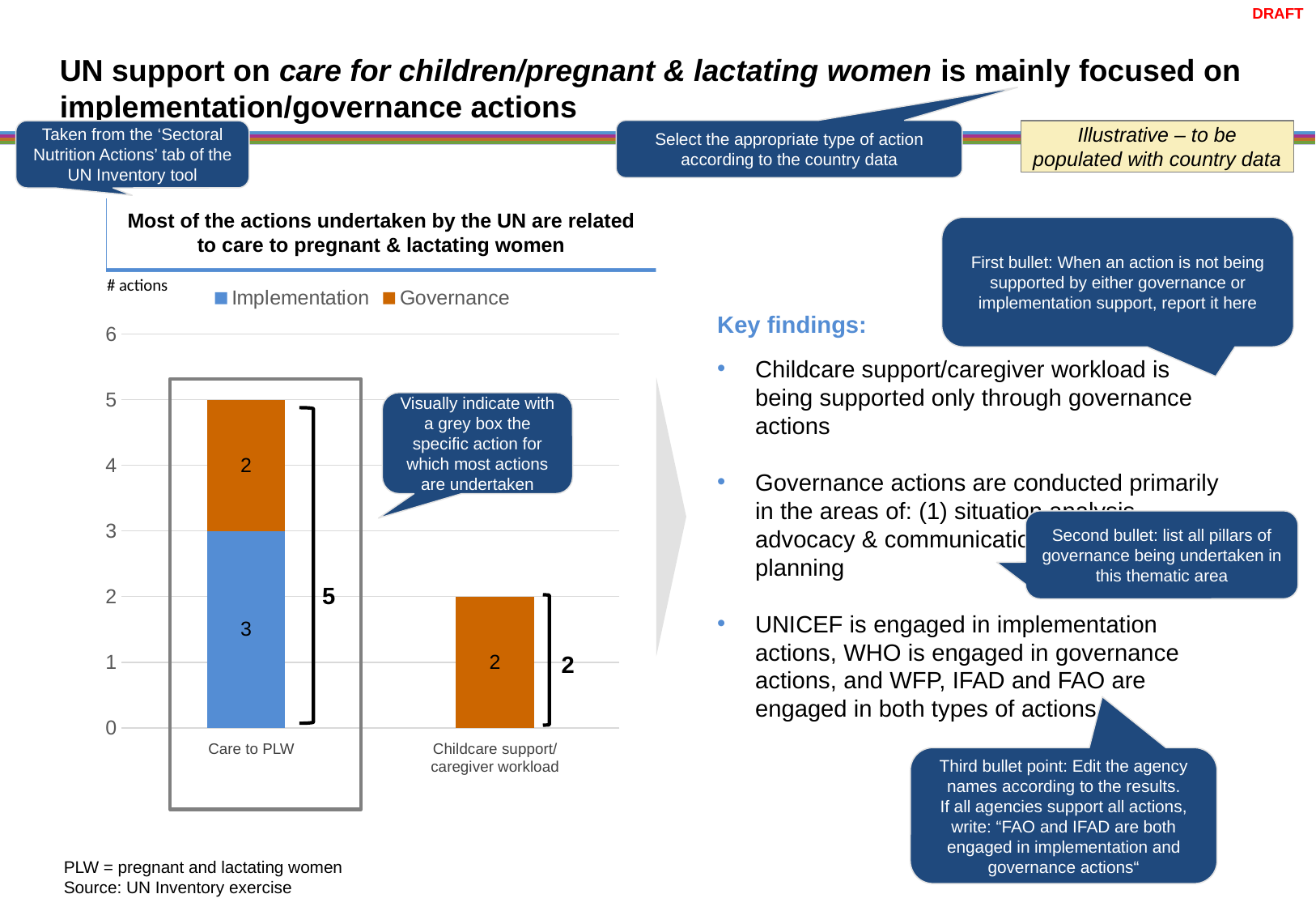
What is the total number of actions for Childcare support/caregiver workload? 2 Which category has the highest total number of actions? Care to PLW Which is larger for Care to PLW: the Implementation value or the Governance value? Implementation How many categories are shown on the x axis of the chart? 2 What is the title of the chart? Most of the actions undertaken by the UN are related to care to pregnant & lactating women What is the Implementation value for Care to PLW? 3 What type of chart is shown on the slide? Stacked bar chart What is the total number of actions for Care to PLW? 5 What is the Governance value for Care to PLW? 2 What is the Governance value for Childcare support/caregiver workload? 2 What is the difference between the total actions for Care to PLW and Childcare support/caregiver workload? 3 How many series does the chart legend list? 2